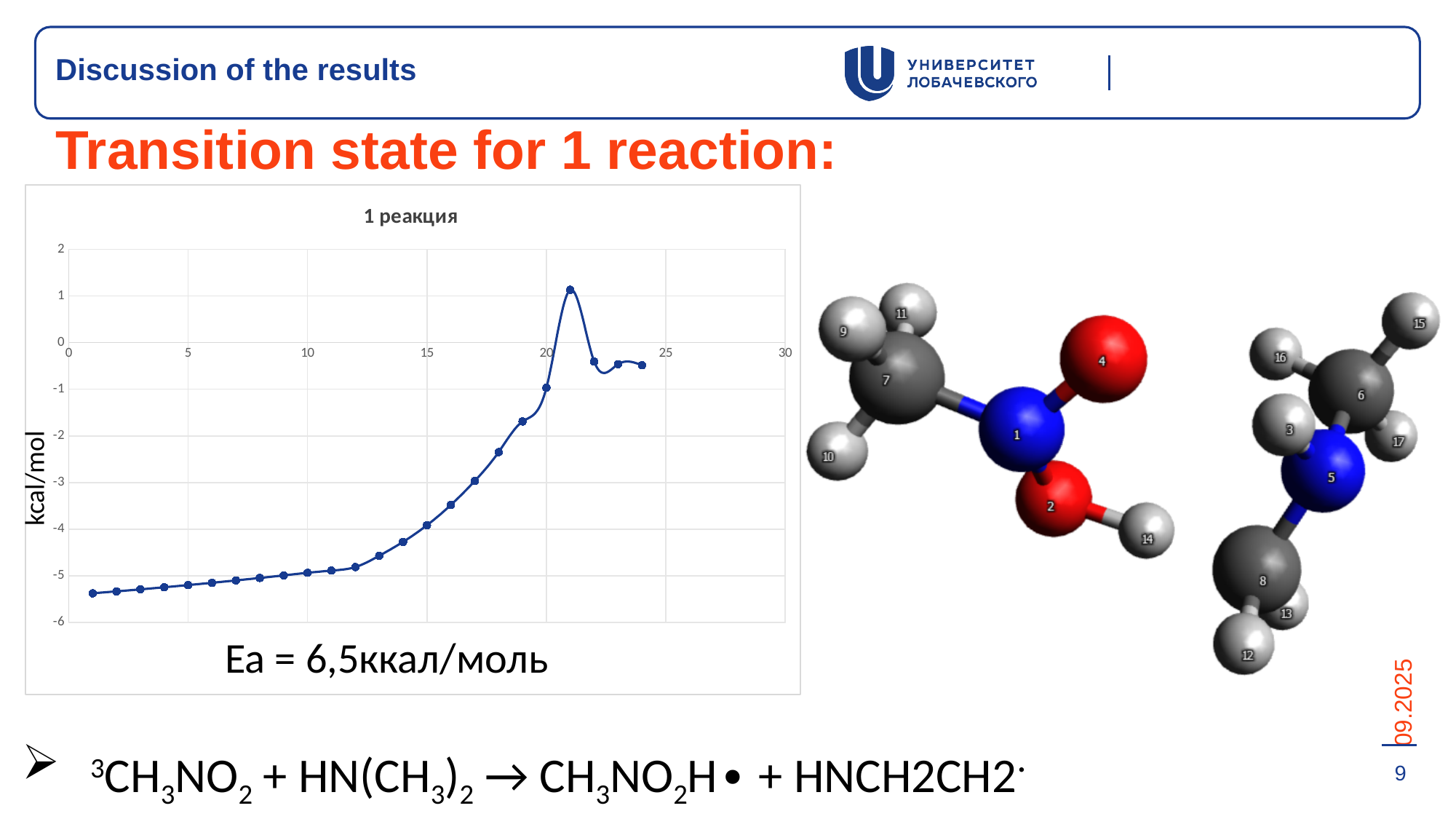
Do the values rise or fall along the x axis from x = 1 to x = 20? rise Is the highest point of the curve greater or less than 0? greater Is the last point of the curve (near x = 24) greater or less than -1? greater Between which two x-axis ticks does the peak of the curve occur? between 20 and 25 What is the title of the chart? 1 реакция Is the value of the first point (at x = 1) greater or less than -5? less What kind of chart is shown on the slide? line chart Which is larger: the value at x = 5 or the value at x = 15? the value at x = 15 What is the maximum value shown on the y axis of the chart? 2 What is the label of the y axis of the chart? kcal/mol